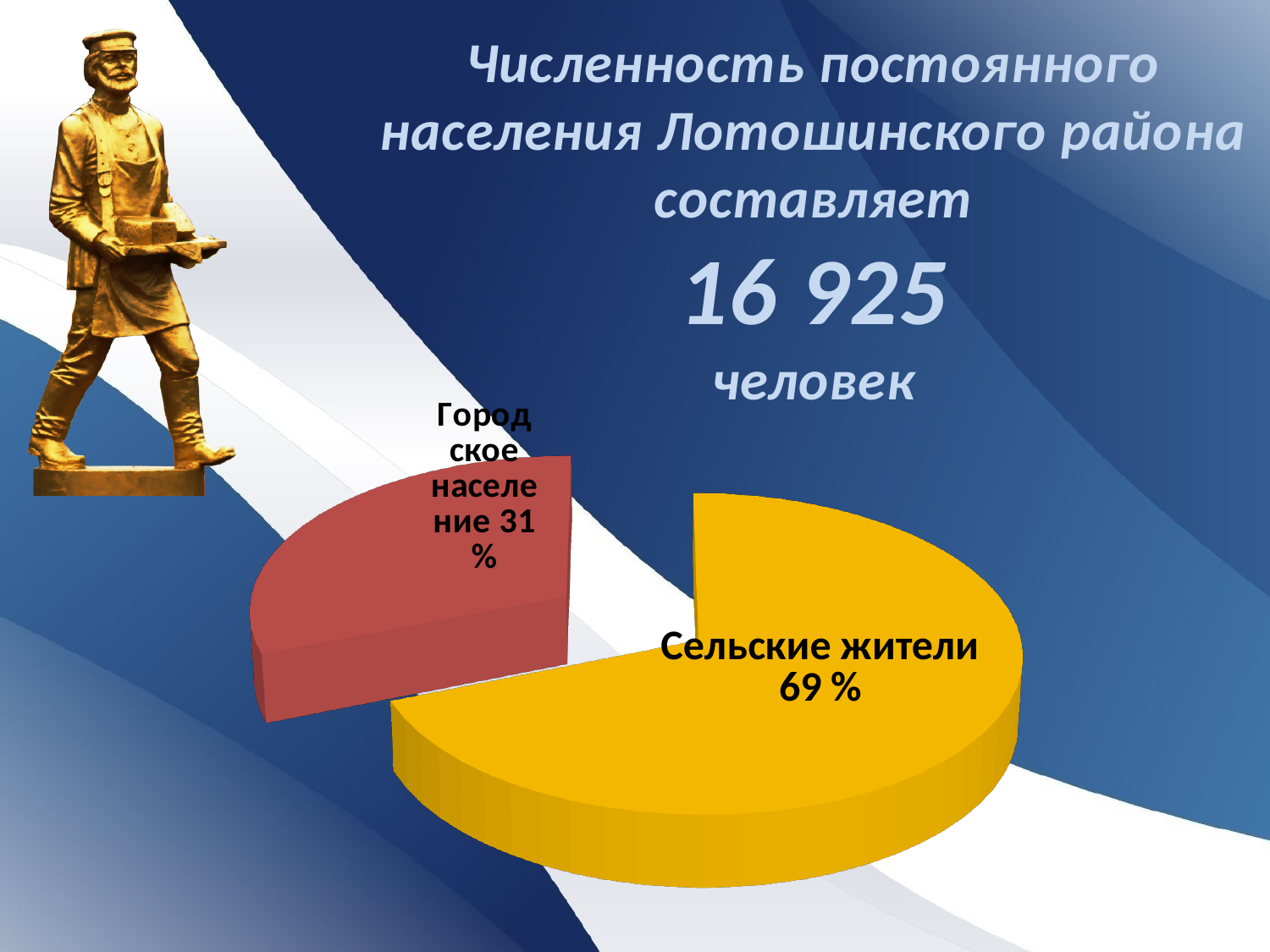
What share of the population is shown for Городское население? 31 % Which is larger, the share for Сельские жители or for Городское население? Сельские жители What share of the population is shown for Сельские жители? 69 % Which slice of the pie chart is the smallest? Городское население What total permanent population figure is stated on the slide? 16 925 What kind of chart is shown on the slide? pie chart What is the difference in percentage points between Сельские жители and Городское население? 38 How many slices does the pie chart have? 2 What colour is the slice for Сельские жители? yellow Which slice of the pie chart is the largest? Сельские жители What colour is the slice for Городское население? red